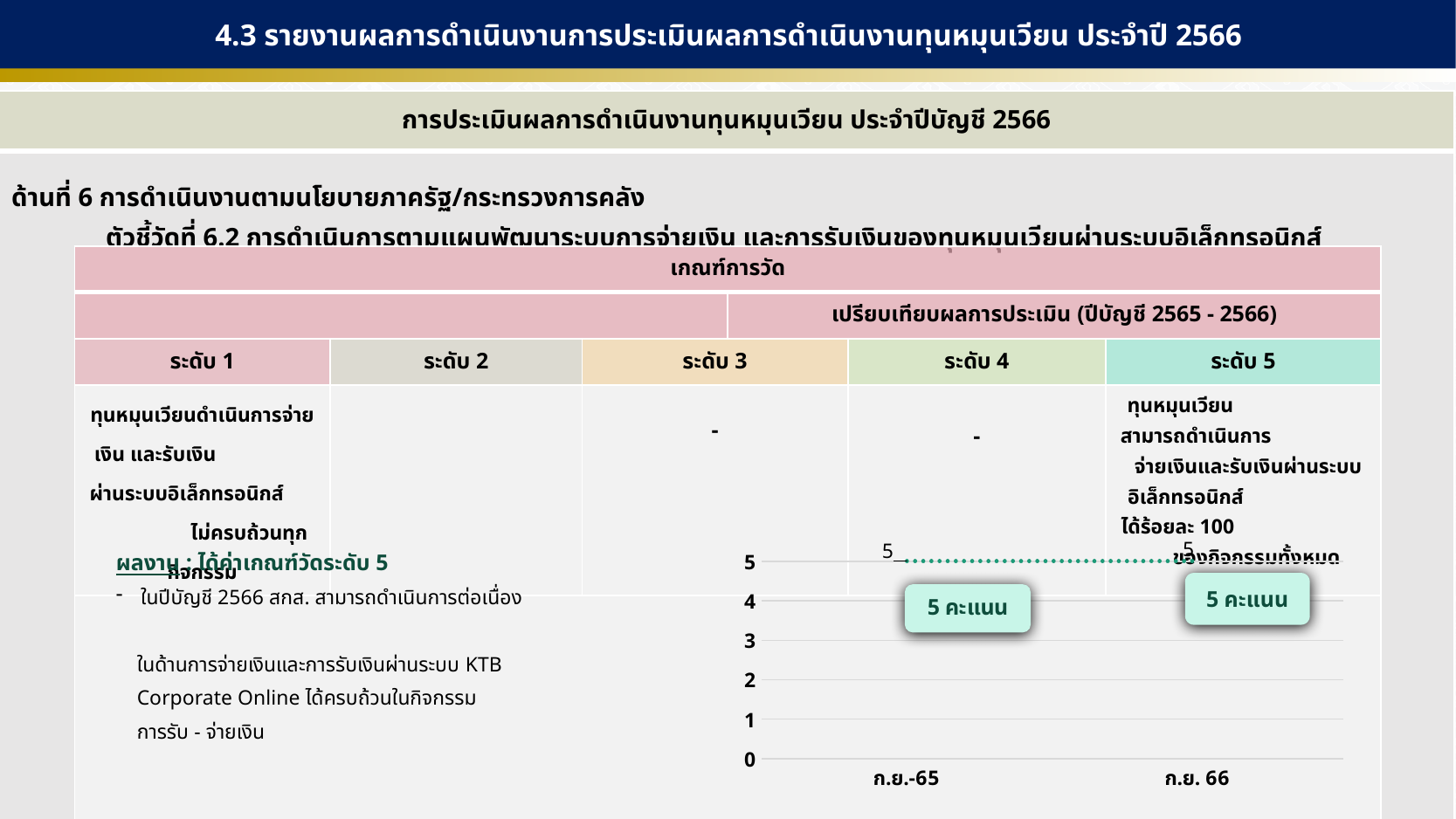
What kind of chart is shown on the slide? line chart What is the highest tick value shown on the chart's vertical axis? 5 What is the difference between the values for ก.ย.-65 and ก.ย. 66? 0 Is the value for ก.ย. 66 higher, lower, or the same as the value for ก.ย.-65? the same Is the value for ก.ย.-65 greater or less than 4? greater How many data points are plotted on the chart? 2 What are the two category labels on the chart's horizontal axis? ก.ย.-65 and ก.ย. 66 What is the value plotted for ก.ย. 66? 5 What is the value plotted for ก.ย.-65? 5 Is the value for ก.ย. 66 greater or less than 3? greater Do the plotted values rise, fall, or stay flat from ก.ย.-65 to ก.ย. 66? stay flat